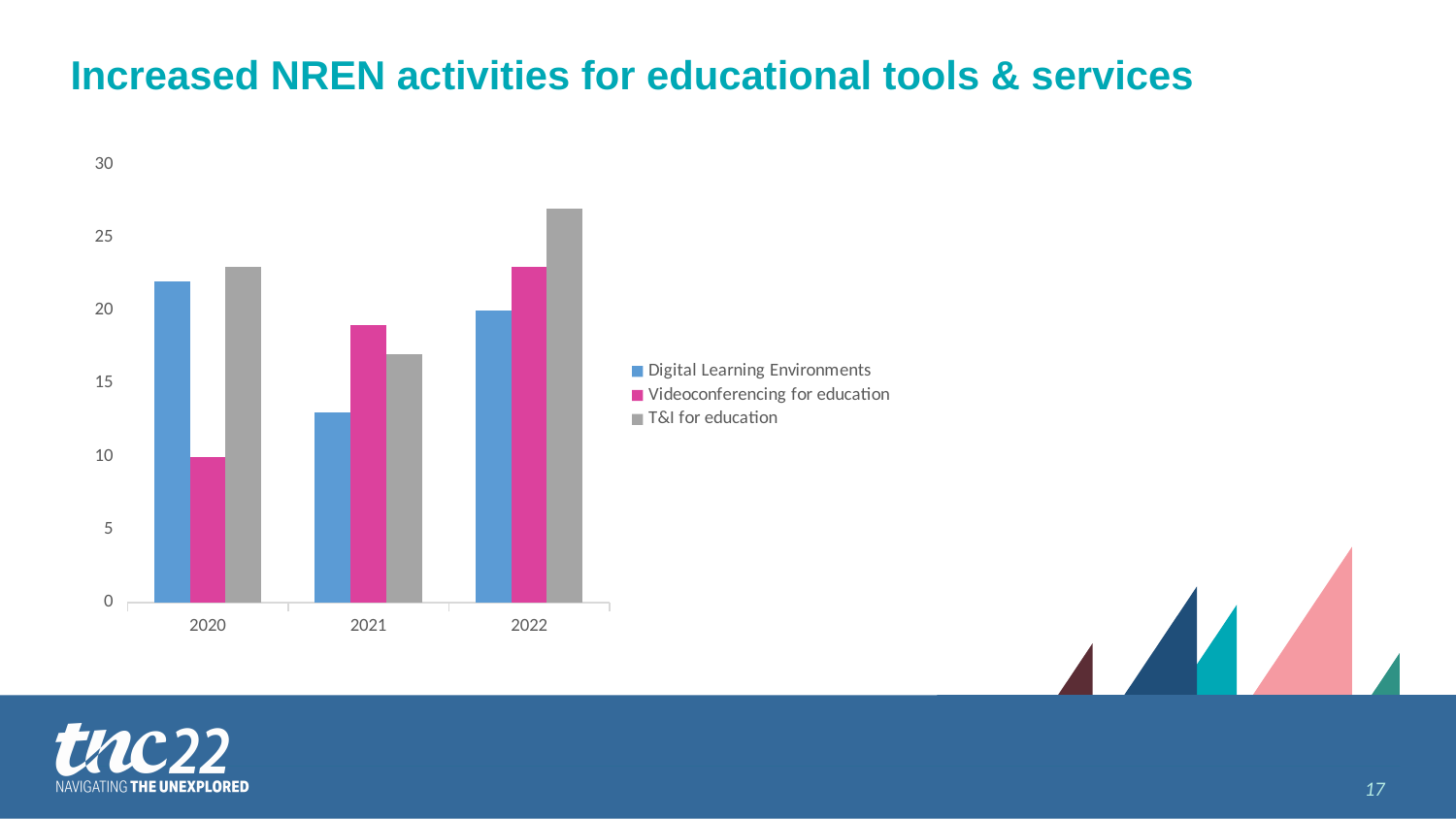
Is the value for T&I for education in 2022 greater or less than 25? greater How many series does the legend list? 3 In 2021, which is larger: Videoconferencing for education or Digital Learning Environments? Videoconferencing for education What kind of chart is shown on the slide? bar chart How many years are shown on the x axis? 3 Does the value for Videoconferencing for education rise or fall from 2020 to 2022? rise Is the value for Digital Learning Environments in 2020 greater or less than 20? greater Which series has the highest value in 2022? T&I for education Is the value for Videoconferencing for education in 2020 greater or less than 15? less What is the title of the slide? Increased NREN activities for educational tools & services Which series has the lowest value in 2020? Videoconferencing for education